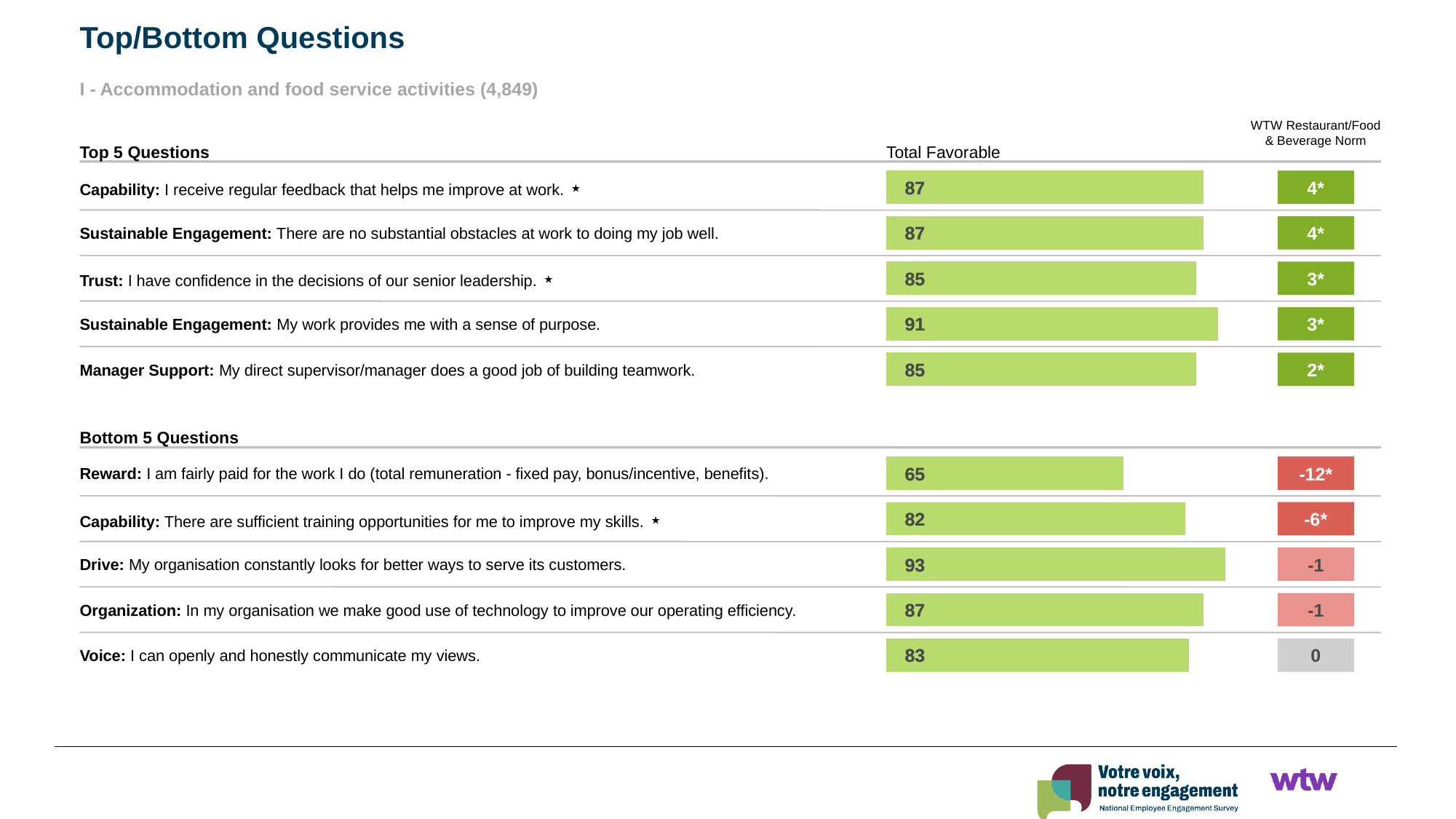
What type of chart is used to show the Total Favorable values on this slide? Bar chart How many questions are shown in the Bottom 5 Questions chart? 5 In the Top 5 Questions chart, what is the Total Favorable value for "Trust: I have confidence in the decisions of our senior leadership"? 85 In the Top 5 Questions chart, which question has the highest Total Favorable value? Sustainable Engagement: My work provides me with a sense of purpose. In the Bottom 5 Questions chart, which has a larger Total Favorable: the Capability training question or the Voice question? Voice In the Bottom 5 Questions chart, what is the difference in Total Favorable between the Drive question (93) and the Reward question (65)? 28 In the Bottom 5 Questions chart, what is the Total Favorable value for "Reward: I am fairly paid for the work I do"? 65 In the Bottom 5 Questions chart, which question has the highest Total Favorable value? Drive: My organisation constantly looks for better ways to serve its customers. In the Top 5 Questions chart, what is the Total Favorable value for "Sustainable Engagement: My work provides me with a sense of purpose"? 91 In the Bottom 5 Questions chart, which question has the lowest Total Favorable value? Reward: I am fairly paid for the work I do (total remuneration - fixed pay, bonus/incentive, benefits). In the Bottom 5 Questions chart, what is the Total Favorable value for "Voice: I can openly and honestly communicate my views"? 83 In the Top 5 Questions chart, what is the difference in Total Favorable between the Sustainable Engagement purpose question (91) and the Manager Support question (85)? 6